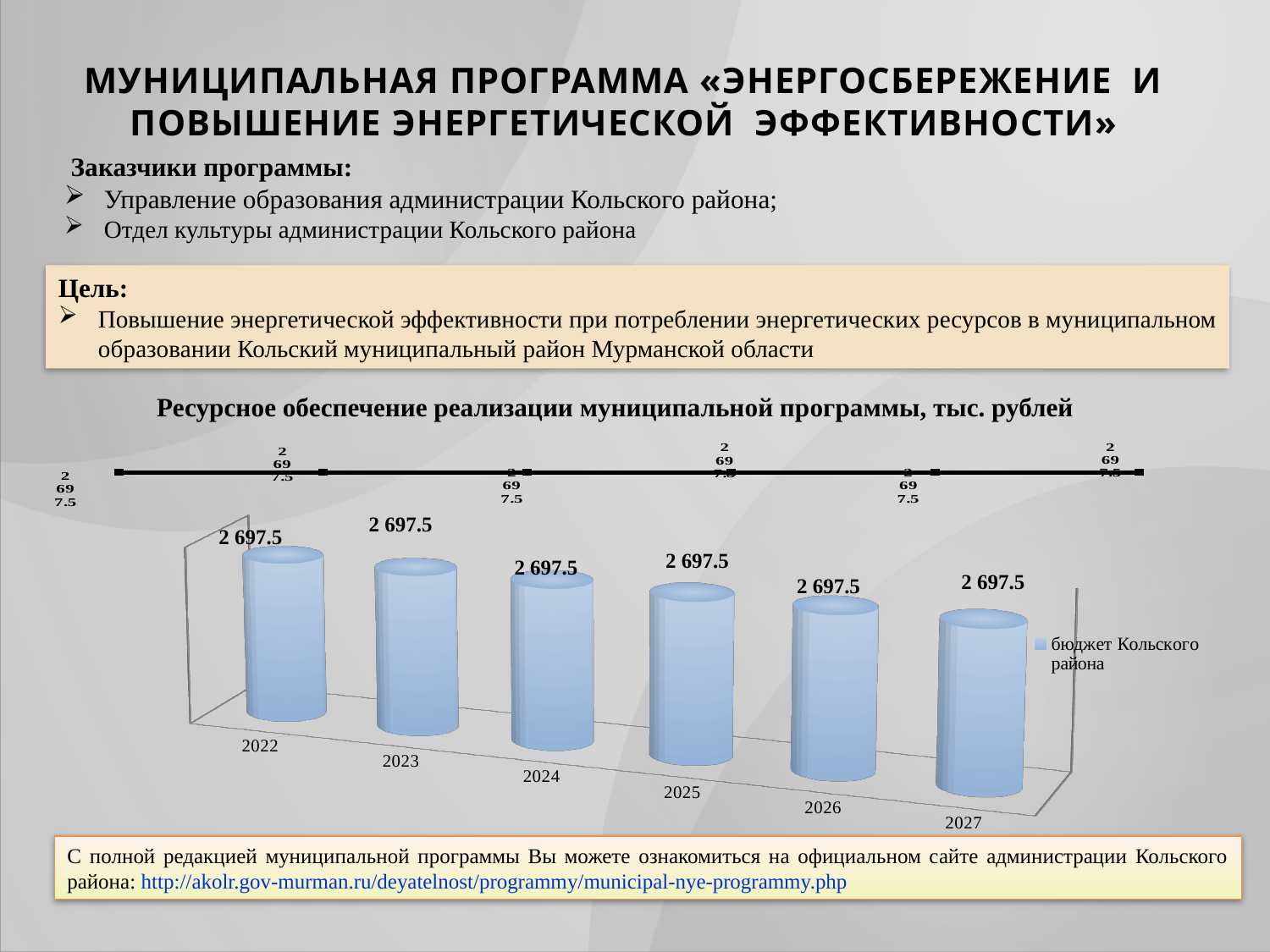
Do the values rise, fall or stay the same from 2022 to 2027? stay the same What is the title of the chart? Ресурсное обеспечение реализации муниципальной программы, тыс. рублей What kind of chart is used to show the resource provision by year? bar chart How many series does the chart legend list? 1 What is the value for 2027 in the chart? 2 697.5 What is the value for 2025 in the chart? 2 697.5 What is the difference between the values for 2023 and 2026? 0 How many years (categories) are shown on the x axis of the chart? 6 What is the value for 2022 in the chart? 2 697.5 What is the name of the series shown in the chart legend? бюджет Кольского района What is the value for 2024 in the chart? 2 697.5 Is the value for 2023 larger than, smaller than, or equal to the value for 2027? equal